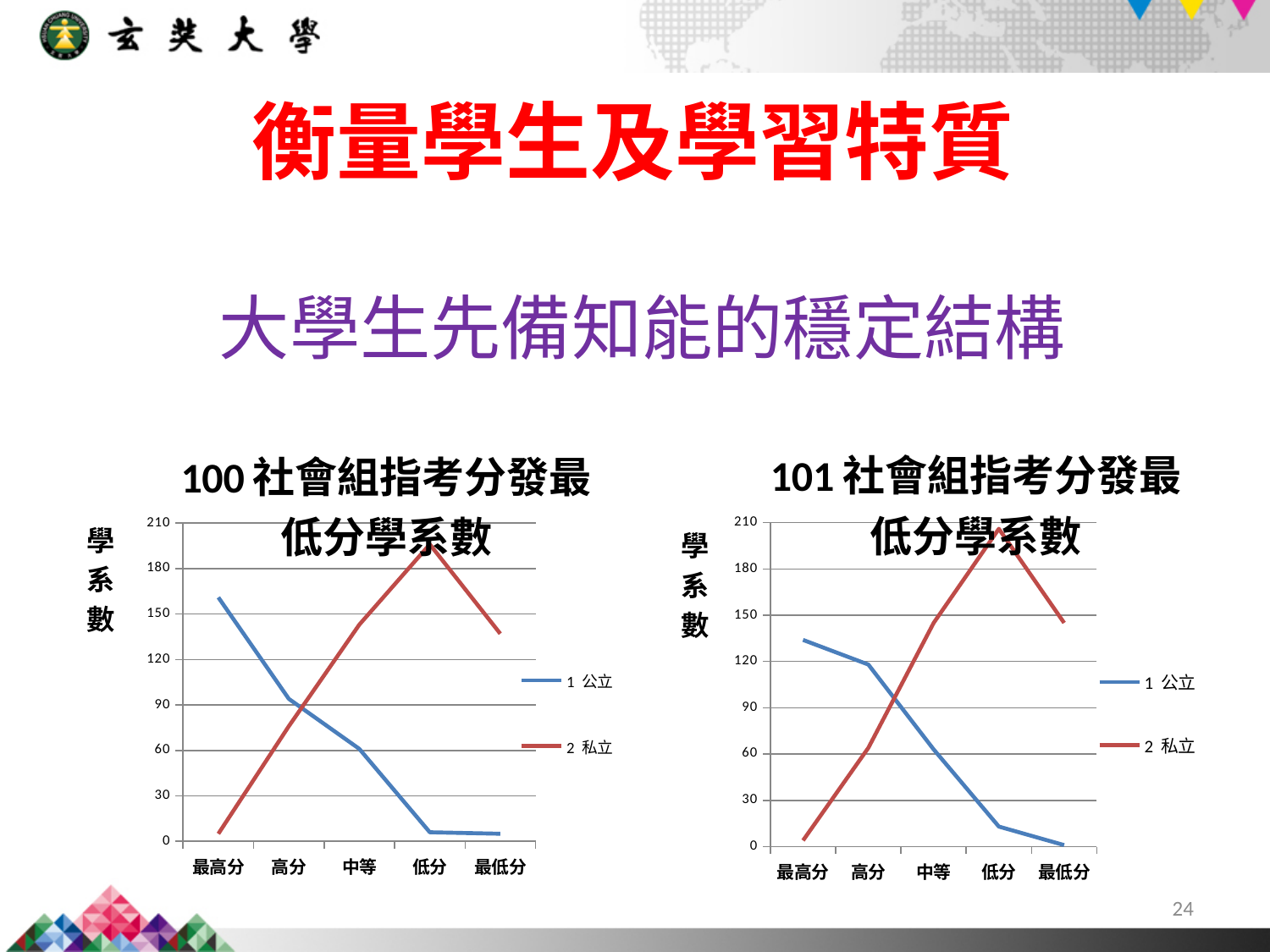
In the left chart (100 社會組指考分發最低分學系數), is the value of 1 公立 at 最高分 greater or less than 150? greater How many categories are shown on the x axis of the left chart (100 社會組指考分發最低分學系數)? 5 In the right chart (101 社會組指考分發最低分學系數), which series has the larger value at 中等, 1 公立 or 2 私立? 2 私立 In the left chart (100 社會組指考分發最低分學系數), is the value of 2 私立 at 低分 greater or less than 180? greater In the right chart (101 社會組指考分發最低分學系數), is the value of 2 私立 at 最高分 greater or less than 30? less In the left chart (100 社會組指考分發最低分學系數), at which category does the 2 私立 series reach its highest value? 低分 In the left chart (100 社會組指考分發最低分學系數), does the 1 公立 series rise or fall from 最高分 to 最低分? fall How many series does the legend of the right chart (101 社會組指考分發最低分學系數) list? 2 In the right chart (101 社會組指考分發最低分學系數), at which category does the 1 公立 series have its lowest value? 最低分 What colour is the line for 2 私立 in the right chart (101 社會組指考分發最低分學系數)? red What kind of chart is the left chart titled 100 社會組指考分發最低分學系數? line chart